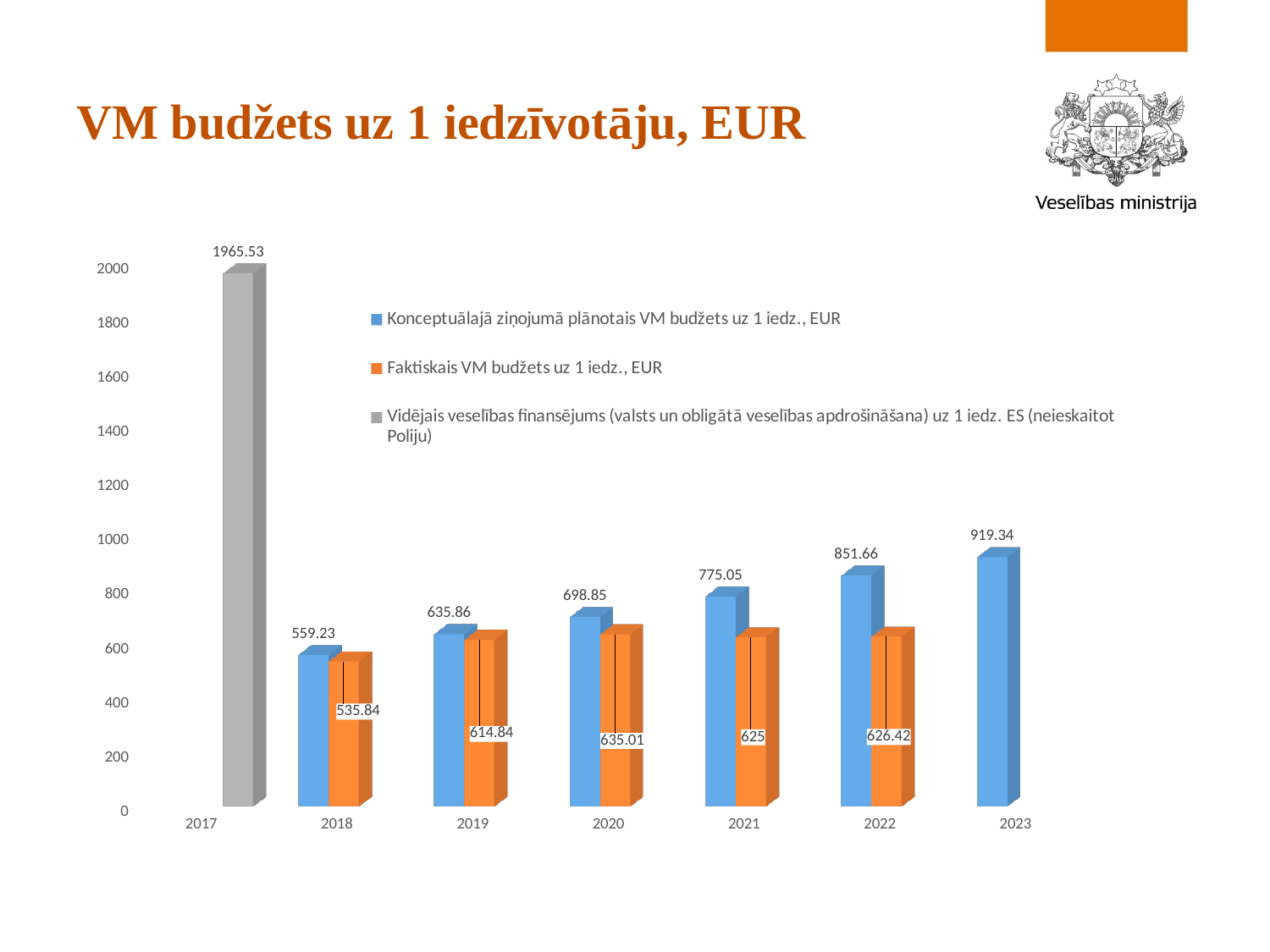
What is the planned VM budget per inhabitant (Konceptuālajā ziņojumā plānotais) for 2023? 919.34 How many years are shown on the x axis of the chart? 7 What is the difference between the planned and actual VM budget per inhabitant in 2022? 225.24 Is the actual VM budget per inhabitant in 2020 greater or less than 600? greater What is the actual VM budget per inhabitant (Faktiskais VM budžets) for 2019? 614.84 In which year is the planned VM budget per inhabitant (blue series) the highest? 2023 How many series does the chart legend list? 3 Which is larger in 2021: the planned VM budget per inhabitant or the actual VM budget per inhabitant? Planned (775.05) Does the planned VM budget per inhabitant (blue series) rise or fall from 2018 to 2023? Rise In which year is the actual VM budget per inhabitant (orange series) the lowest? 2018 What value is shown for the EU average health financing per inhabitant in 2017? 1965.53 What kind of chart is shown on the slide? Bar chart